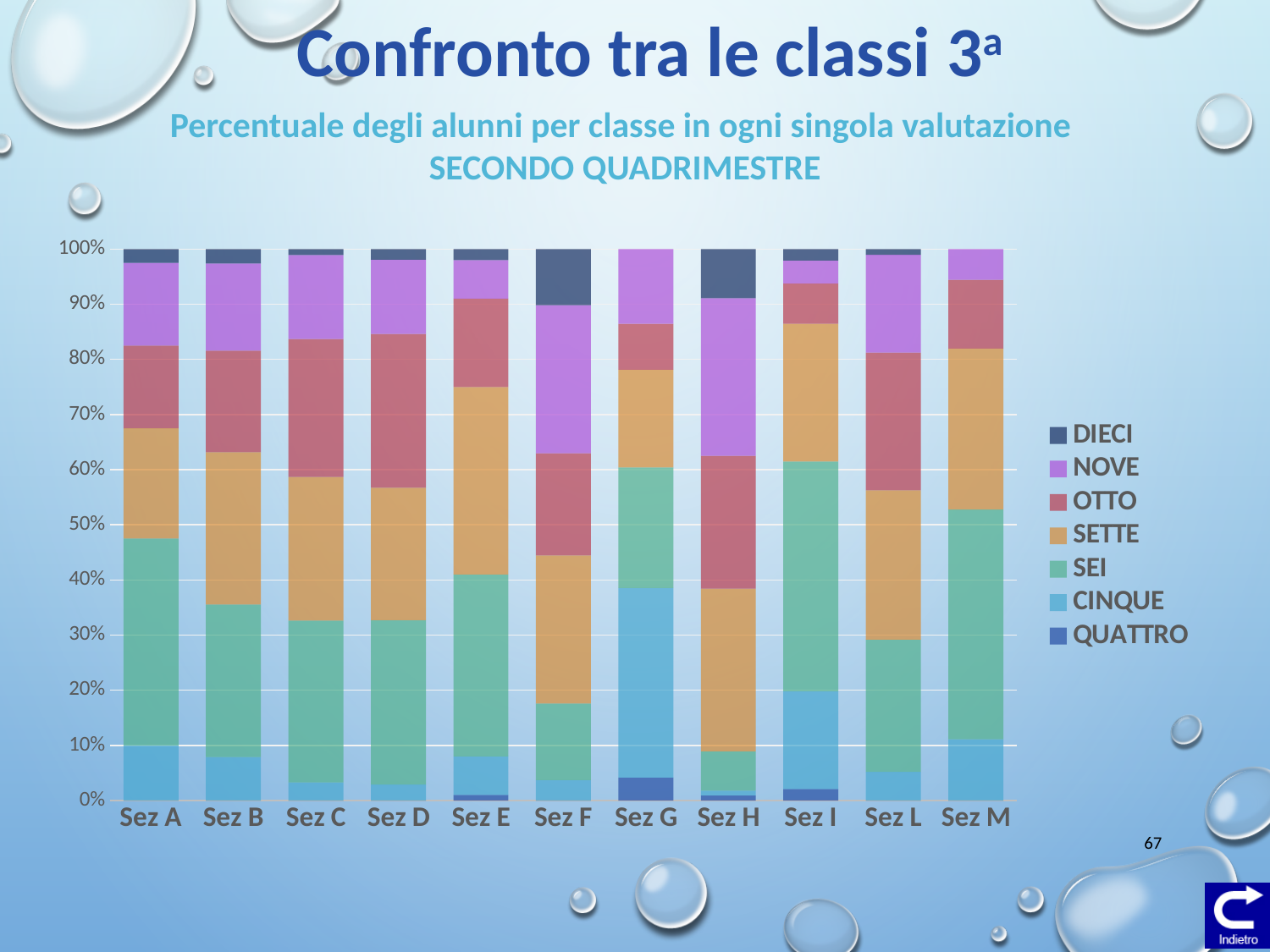
Which is larger: the CINQUE share for Sez G or the CINQUE share for Sez A? Sez G Is the CINQUE share for Sez G greater or less than 30%? greater What is the title of the slide? Confronto tra le classi 3a Is the NOVE share for Sez F greater or less than 20%? greater Which section has the largest CINQUE share? Sez G How many sections (classes) are shown on the x axis of the chart? 11 Is the SETTE share for Sez E greater or less than 30%? greater How many series does the chart legend list? 7 What kind of chart is shown on the slide? Stacked bar chart Which series is listed first (at the top) in the chart legend? DIECI